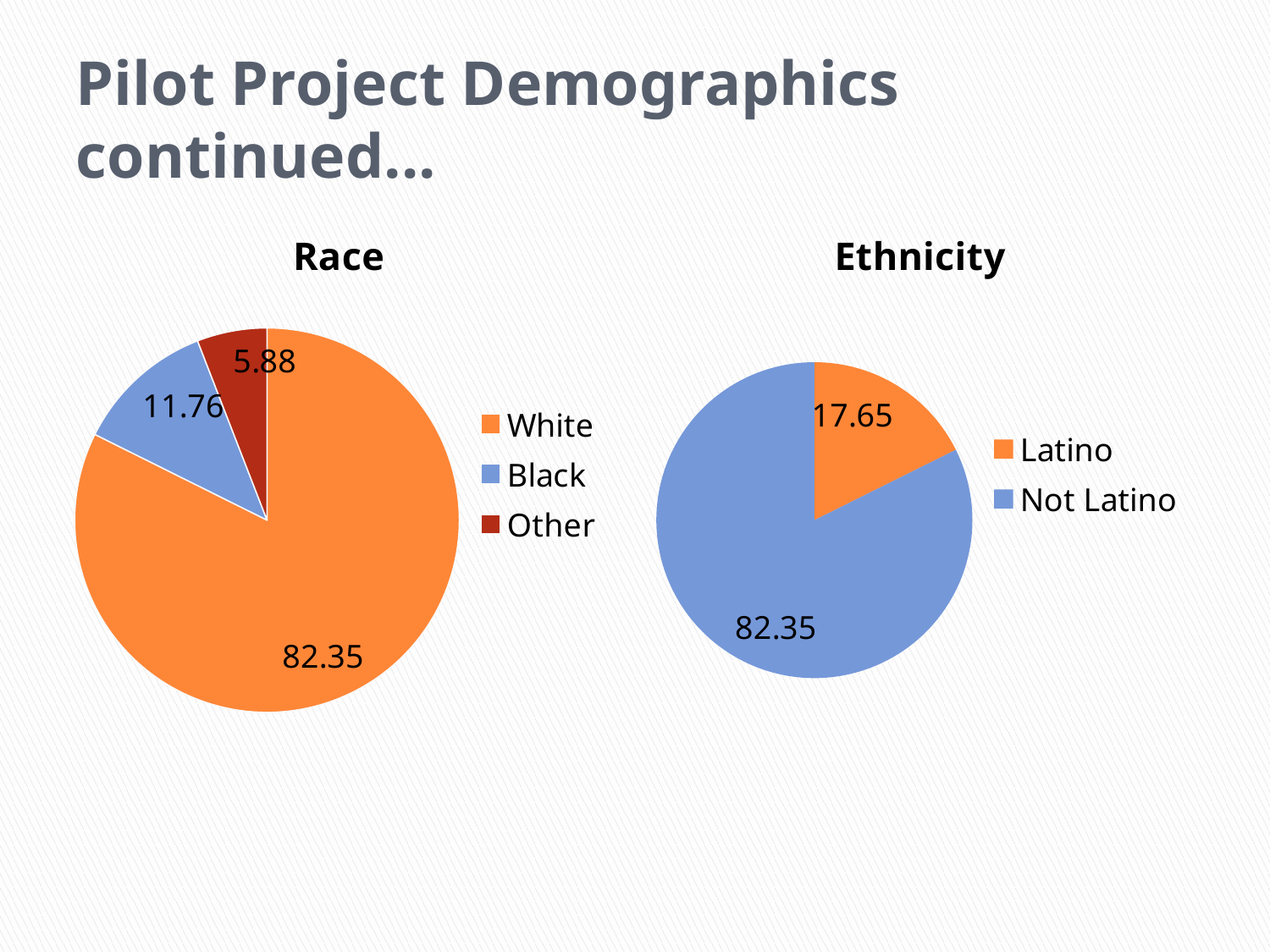
In the Ethnicity chart, what is the value for Not Latino? 82.35 In the Ethnicity chart, what is the difference between the values for Not Latino and Latino? 64.7 In the Ethnicity chart, which is larger, Latino or Not Latino? Not Latino In the Race chart, which category has the largest slice? White In the Race chart, what is the difference between the values for Black and Other? 5.88 In the Race chart, what is the value for Other? 5.88 In the Race chart, what is the value for White? 82.35 In the Race chart, which category has the smallest slice? Other In the Ethnicity chart, what is the value for Latino? 17.65 How many categories does the Race chart show? 3 What kind of chart is the Ethnicity chart? Pie chart In the Race chart, what is the value for Black? 11.76